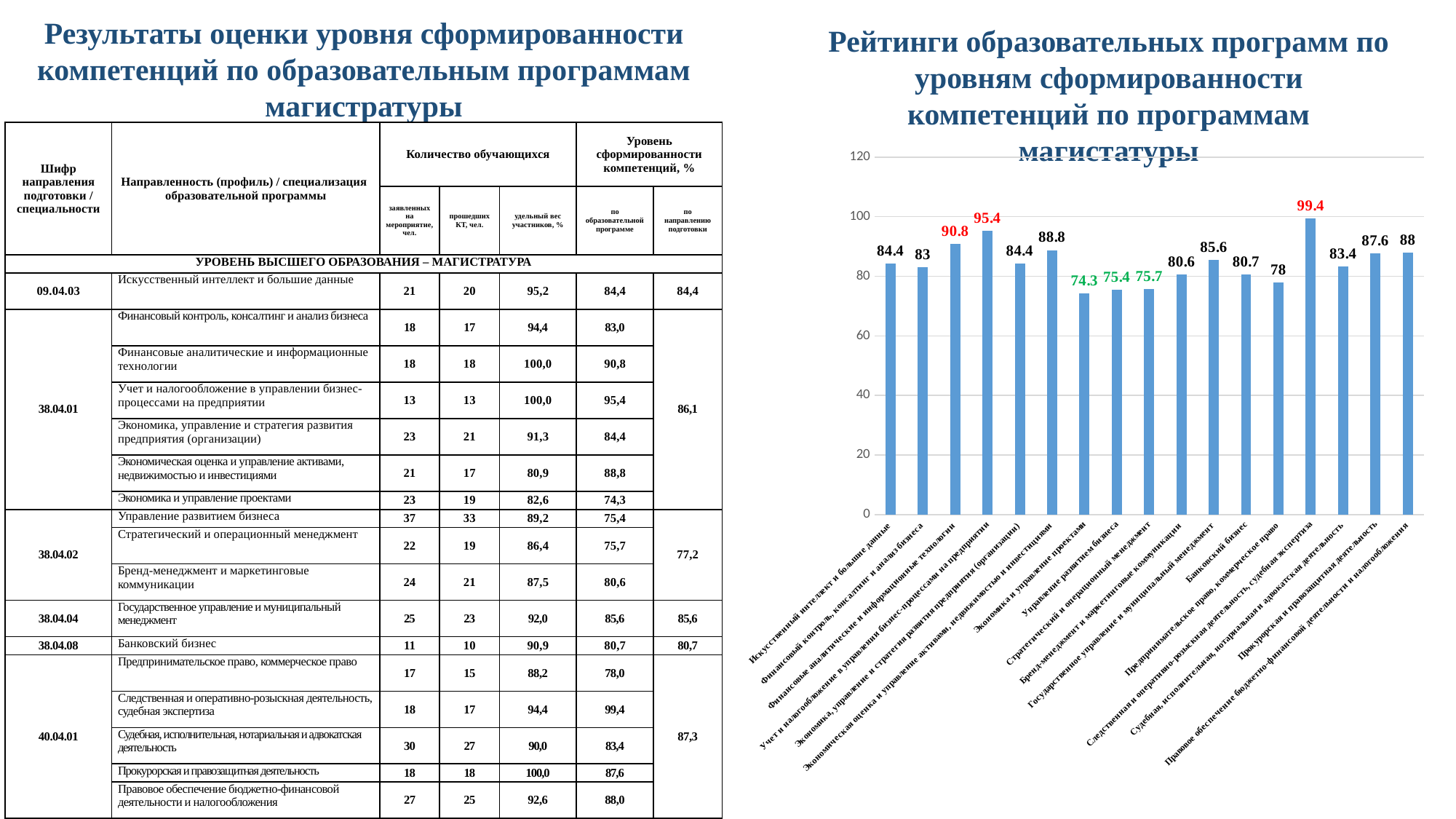
What is the value for Банковский бизнес in the chart? 80.7 Which program has the lowest value in the chart? Экономика и управление проектами How many bars (educational programs) are plotted in the chart? 17 Which is larger in the chart: the value for Финансовые аналитические и информационные технологии or the value for Государственное управление и муниципальный менеджмент? Финансовые аналитические и информационные технологии What is the difference between the highest value (99.4) and the lowest value (74.3) in the chart? 25.1 What is the maximum value shown on the vertical axis of the chart? 120 What is the value for Прокурорская и правозащитная деятельность in the chart? 87.6 What type of chart is shown on the right side of the slide? bar chart What is the highest value shown in the chart? 99.4 What is the value for Учет и налогообложение в управлении бизнес-процессами на предприятии in the chart? 95.4 Is the value for Предпринимательское право, коммерческое право greater or less than 80? less Which program has the highest value in the chart? Следственная и оперативно-розыскная деятельность, судебная экспертиза